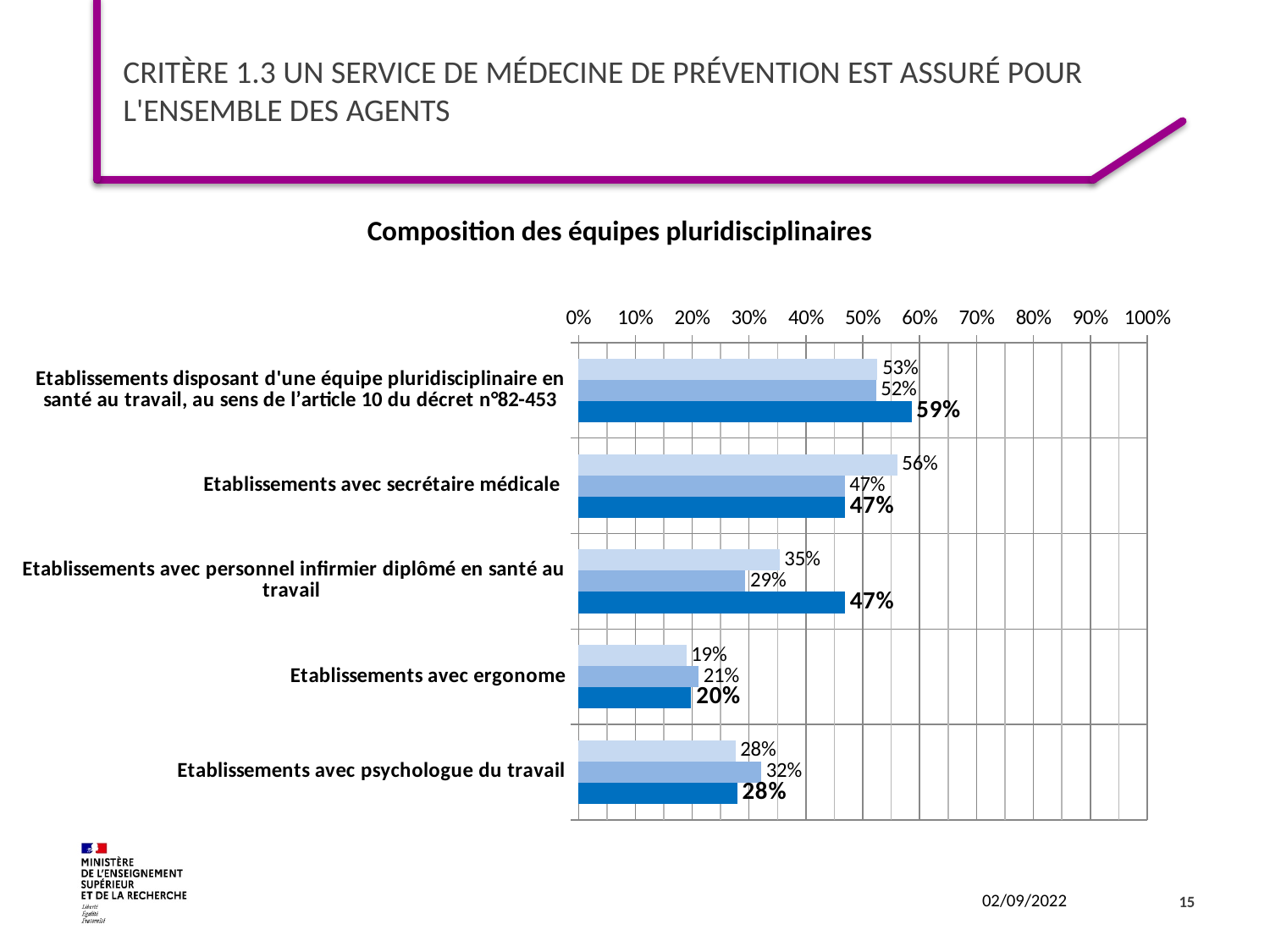
What kind of chart is shown on the slide? bar chart What is the value of the light blue (top) bar for 'Etablissements avec secrétaire médicale'? 56% Is the light blue (top) bar value for 'Etablissements avec secrétaire médicale' greater or less than 50%? greater What is the title of the chart? Composition des équipes pluridisciplinaires For 'Etablissements avec psychologue du travail', which is larger: the medium blue (middle) bar or the dark blue (bottom) bar? the medium blue (middle) bar What is the difference between the dark blue (bottom) bar and the medium blue (middle) bar for 'Etablissements avec personnel infirmier diplômé en santé au travail'? 18% What is the value of the dark blue (bottom) bar for 'Etablissements disposant d'une équipe pluridisciplinaire en santé au travail, au sens de l'article 10 du décret n°82-453'? 59% How many categories are shown on the chart? 5 How many bars are plotted for each category? 3 Which category has the lowest light blue (top) bar value? Etablissements avec ergonome Which category has the highest dark blue (bottom) bar value? Etablissements disposant d'une équipe pluridisciplinaire en santé au travail, au sens de l'article 10 du décret n°82-453 What is the value of the medium blue (middle) bar for 'Etablissements avec personnel infirmier diplômé en santé au travail'? 29%